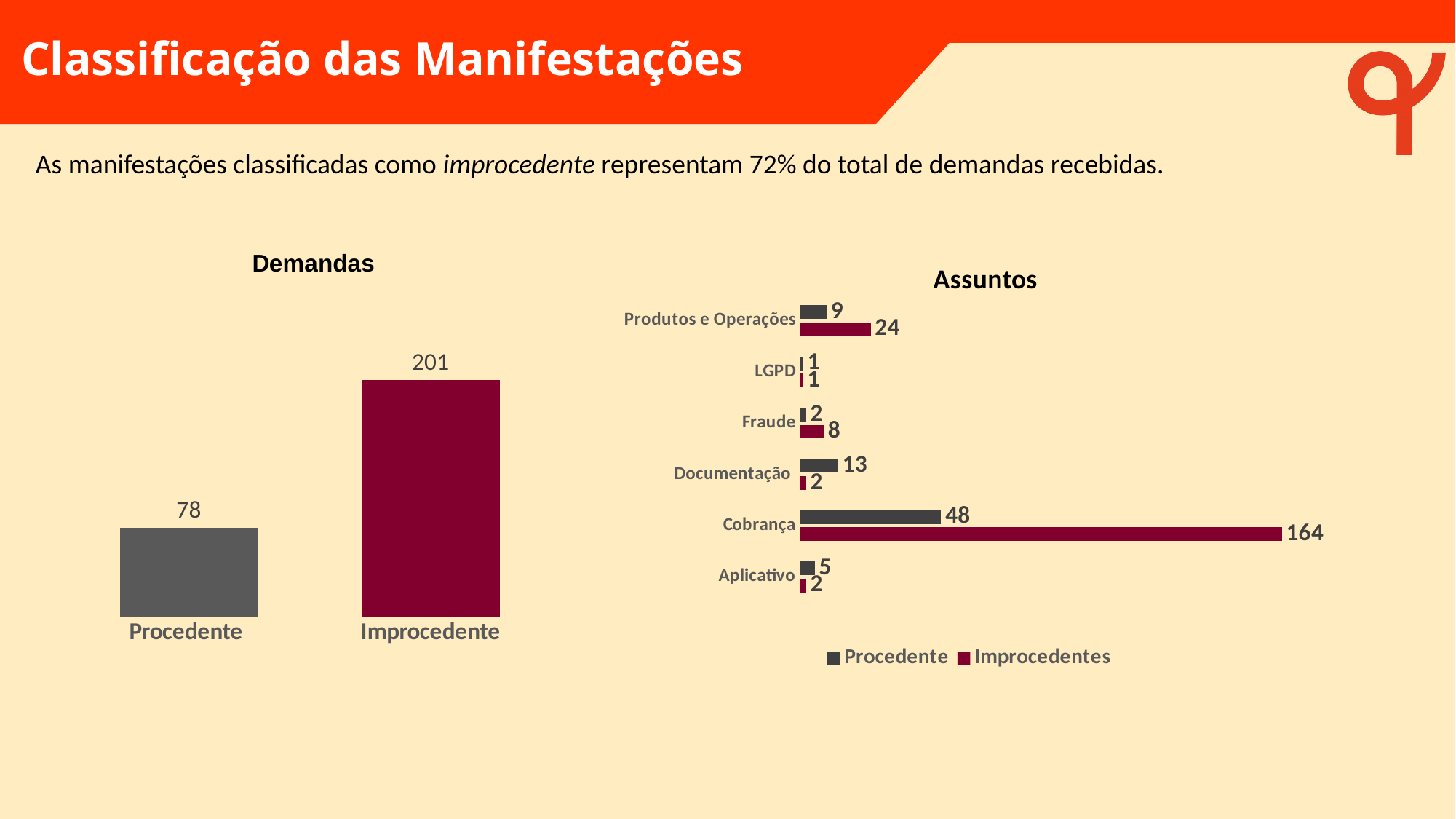
In the 'Assuntos' chart, what is the Improcedentes value for Cobrança? 164 In the 'Assuntos' chart, what is the difference between the Procedente and Improcedentes values for Cobrança? 116 In the 'Assuntos' chart, which category has the highest Improcedentes value? Cobrança In the 'Demandas' chart, what is the difference between Improcedente and Procedente? 123 In the 'Demandas' chart, what is the value for Improcedente? 201 In the 'Demandas' chart, what is the value for Procedente? 78 In the 'Assuntos' chart, how many series does the legend list? 2 In the 'Assuntos' chart, which category has the lowest Procedente value? LGPD In the 'Assuntos' chart, how many categories are shown? 6 In the 'Assuntos' chart, what is the Procedente value for Documentação? 13 In the 'Demandas' chart, what kind of chart is shown? bar chart In the 'Assuntos' chart, which is larger for Produtos e Operações: Procedente or Improcedentes? Improcedentes